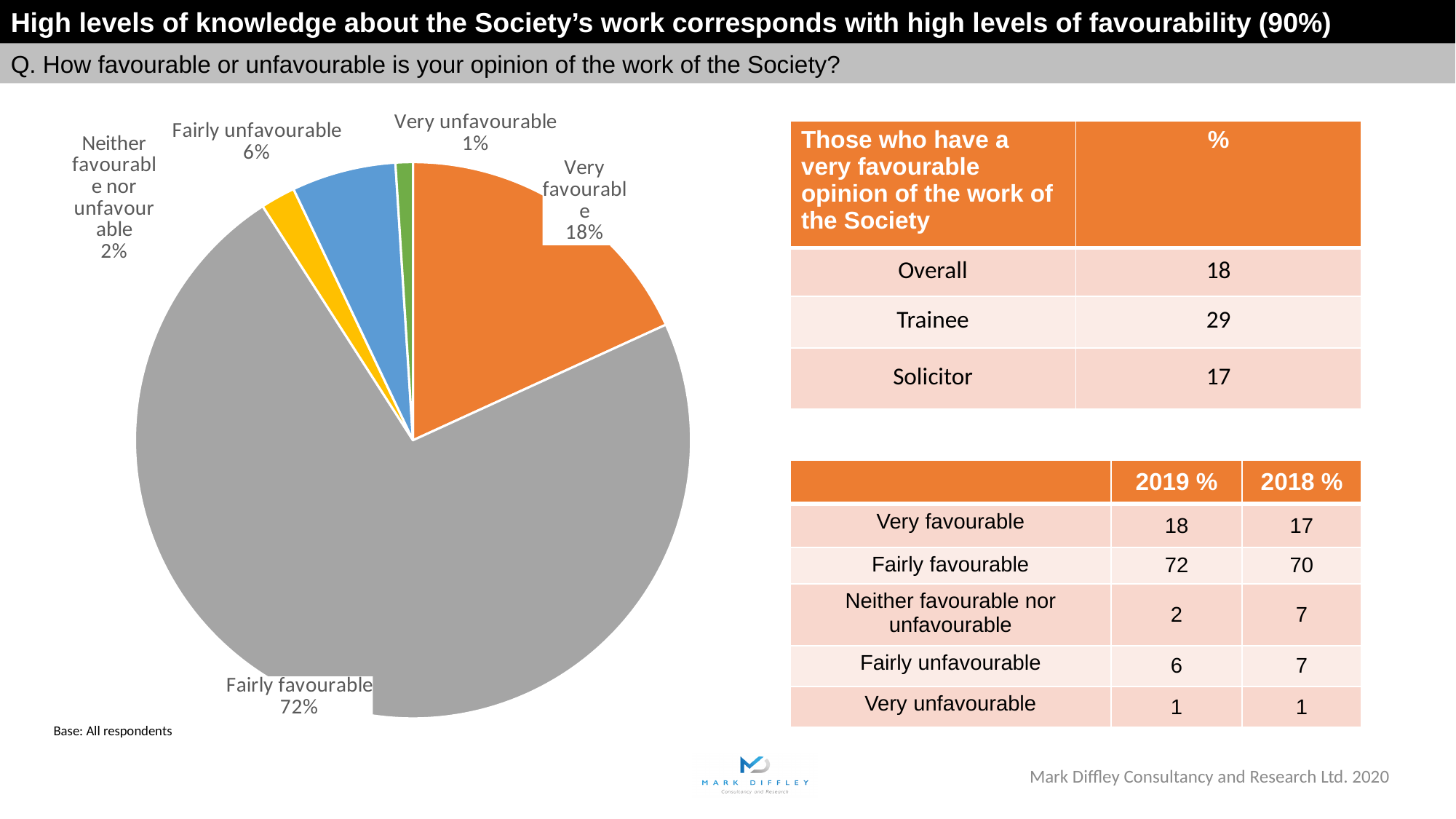
What colour is the fairly favourable slice in the pie chart? Grey What percentage of respondents are neither favourable nor unfavourable in the pie chart? 2% How many slices does the pie chart have? 5 Which category has the largest slice in the pie chart? Fairly favourable Which category has the smallest slice in the pie chart? Very unfavourable What is the difference in percentage points between the fairly favourable and very favourable slices in the pie chart? 54 What percentage of respondents are very unfavourable in the pie chart? 1% What percentage of respondents are very favourable in the pie chart? 18% Which slice is larger in the pie chart, fairly unfavourable or neither favourable nor unfavourable? Fairly unfavourable What percentage of respondents are fairly unfavourable in the pie chart? 6% What kind of chart is shown on the slide? Pie chart What percentage of respondents are fairly favourable towards the work of the Society in the pie chart? 72%